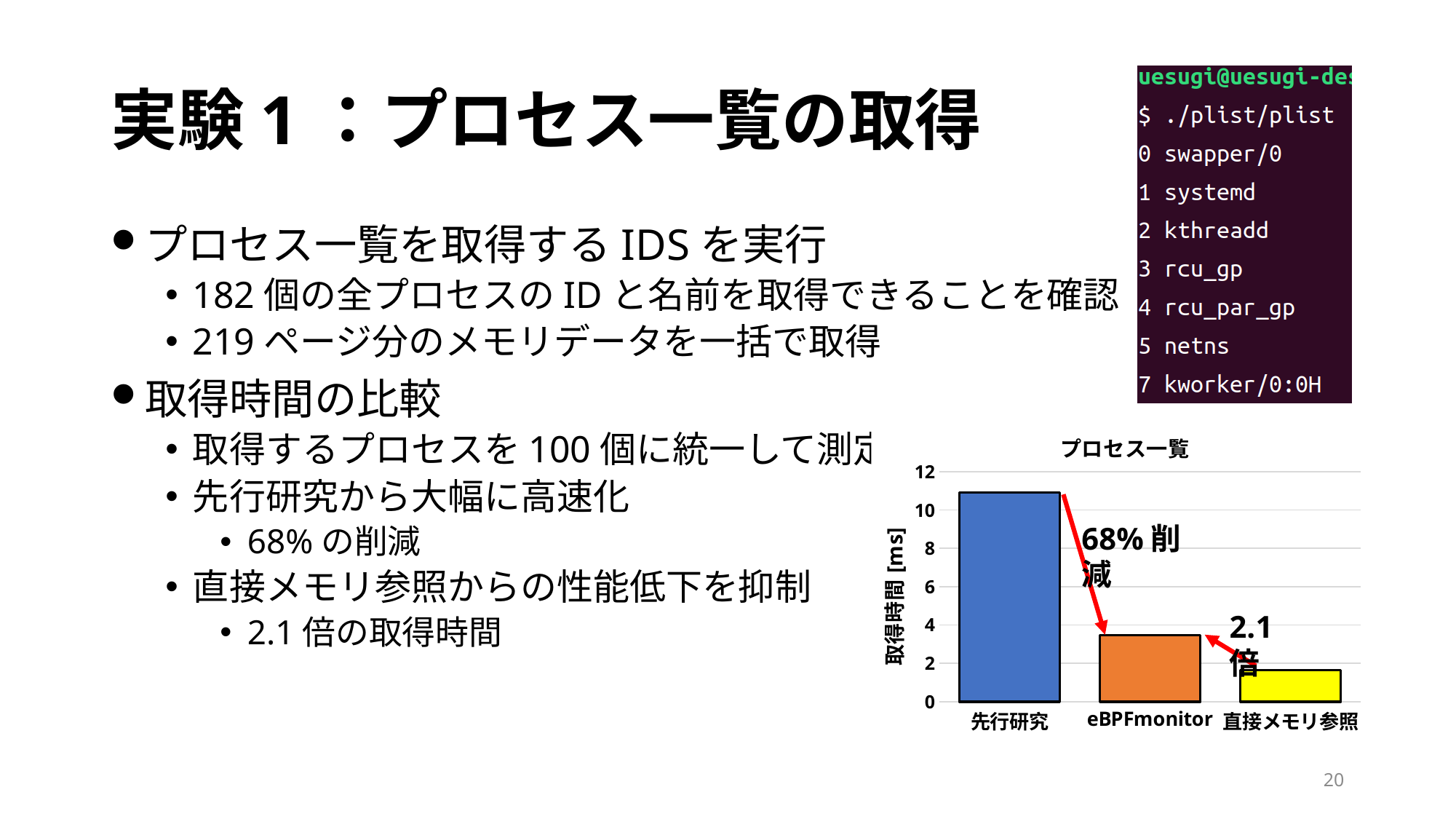
What is the title of the chart? プロセス一覧 Is the value for 先行研究 greater or less than 10? greater Which has a larger value, 先行研究 or eBPFmonitor? 先行研究 Is the value for eBPFmonitor greater or less than 4? less Which category has the lowest 取得時間 in the chart? 直接メモリ参照 What is the label of the vertical axis of the chart? 取得時間 [ms] How many bars (categories) does the chart show? 3 Is the value for 直接メモリ参照 greater or less than 2? less What kind of chart is shown on the slide? bar chart Do the bar values rise or fall from left to right across the categories? fall Which has a larger value, eBPFmonitor or 直接メモリ参照? eBPFmonitor Which category has the highest 取得時間 in the chart? 先行研究